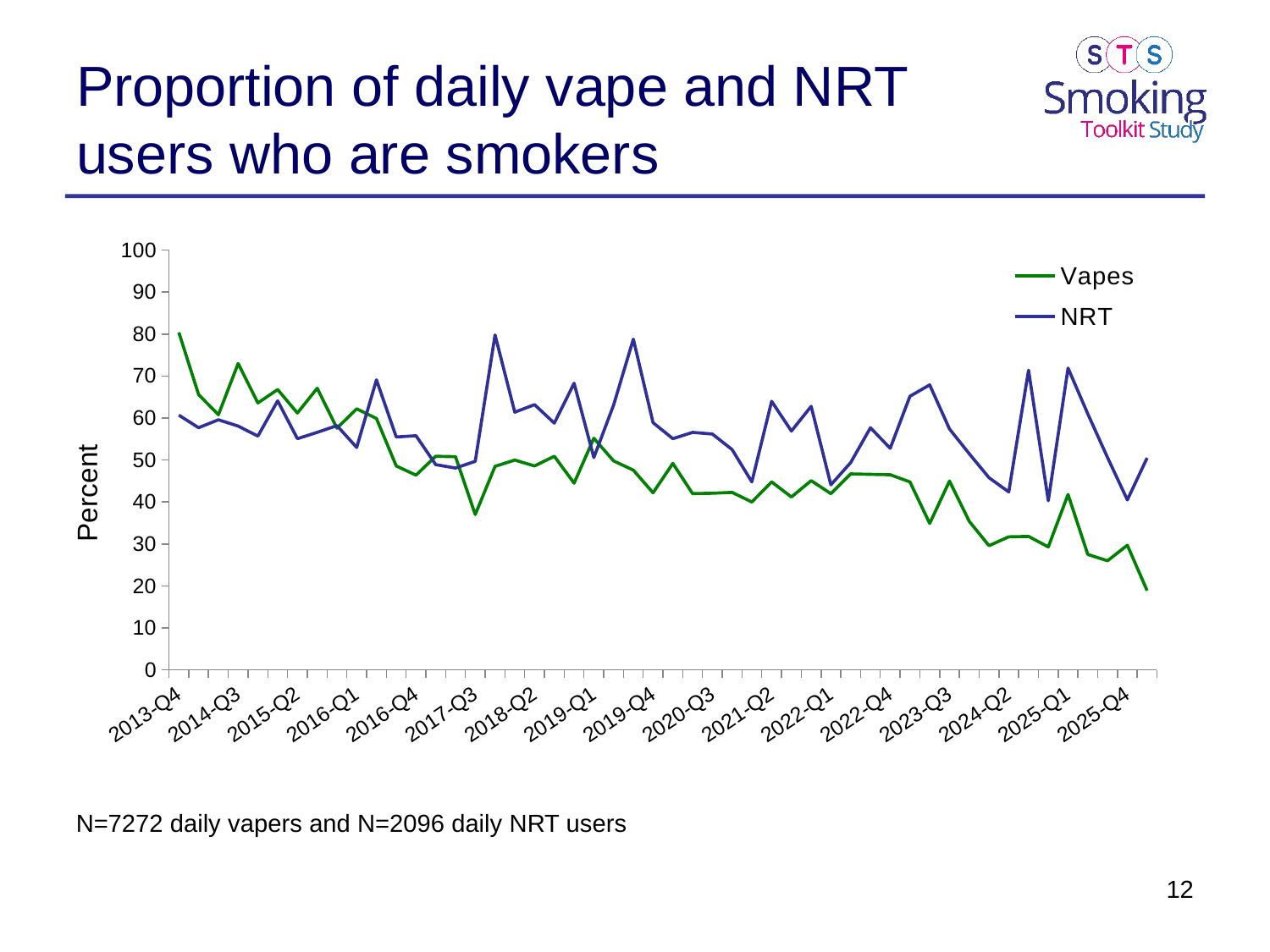
What kind of chart is shown on the slide? line chart What is the label on the y axis? Percent Which series ends the chart at the lower value? Vapes Is the value for Vapes at 2013-Q4 greater or less than 70? greater Is the final plotted value of the Vapes series greater or less than 30? less How many series does the legend list? 2 Is the value for NRT at 2013-Q4 greater or less than 50? greater At 2013-Q4, which series has the higher value, Vapes or NRT? Vapes Which two series are shown in the legend? Vapes and NRT At the last plotted point, which series has the higher value, Vapes or NRT? NRT What is the highest value shown on the y axis? 100 Does the Vapes series generally rise or fall from 2013-Q4 to the end of the chart? fall